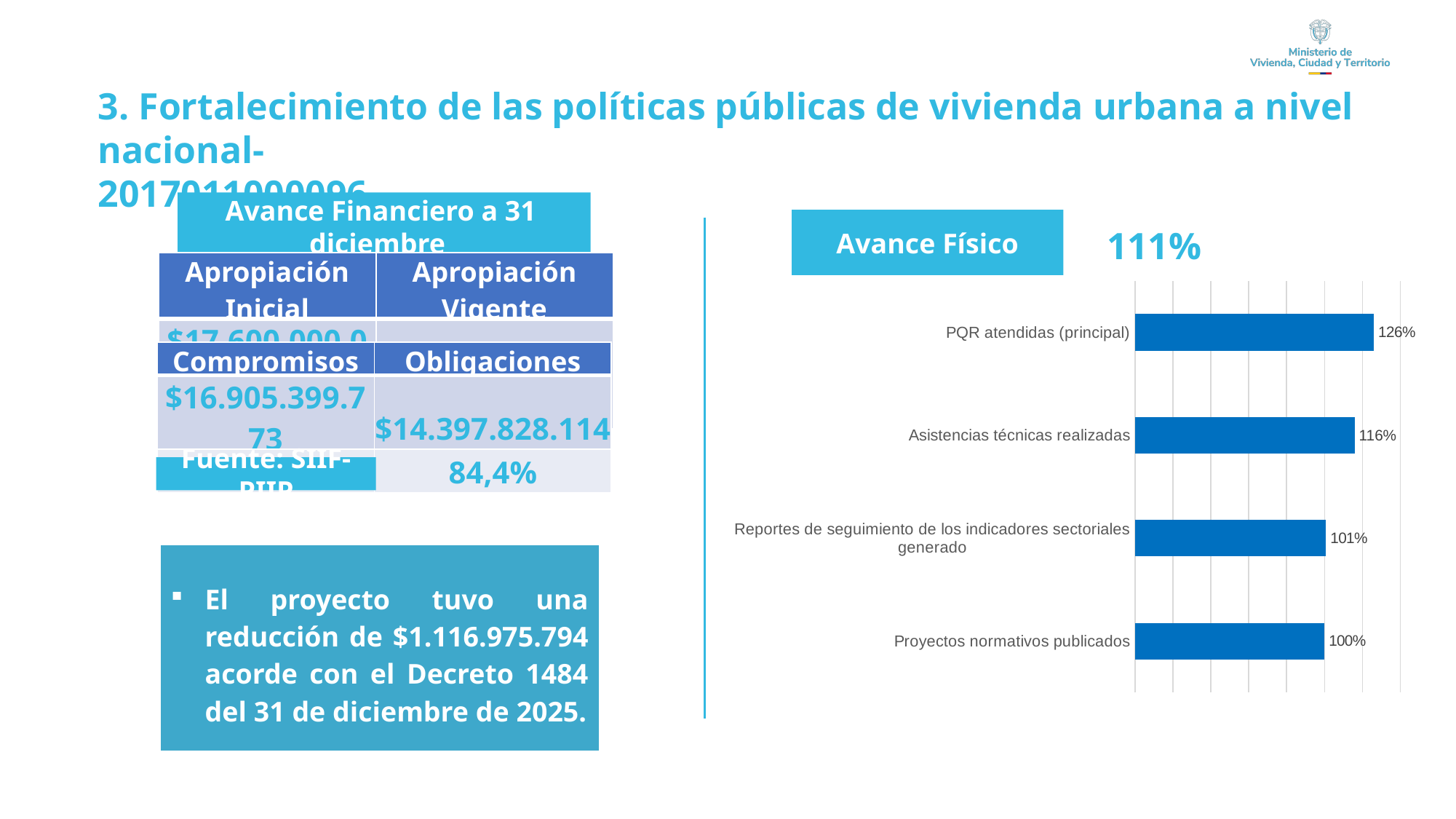
Which category has the highest value? PQR atendidas (principal) What is the difference between the values for Asistencias técnicas realizadas and Proyectos normativos publicados? 16% What kind of chart is shown on the slide? Bar chart What is the value for Asistencias técnicas realizadas? 116% What is the overall Avance Físico percentage shown next to the chart heading? 111% How many categories are shown in the chart? 4 Which is larger, the value for Asistencias técnicas realizadas or the value for Reportes de seguimiento de los indicadores sectoriales generado? Asistencias técnicas realizadas What is the difference between the values for PQR atendidas (principal) and Asistencias técnicas realizadas? 10% What is the value for Proyectos normativos publicados? 100% What is the value for Reportes de seguimiento de los indicadores sectoriales generado? 101% Which category has the lowest value? Proyectos normativos publicados What is the value for PQR atendidas (principal)? 126%